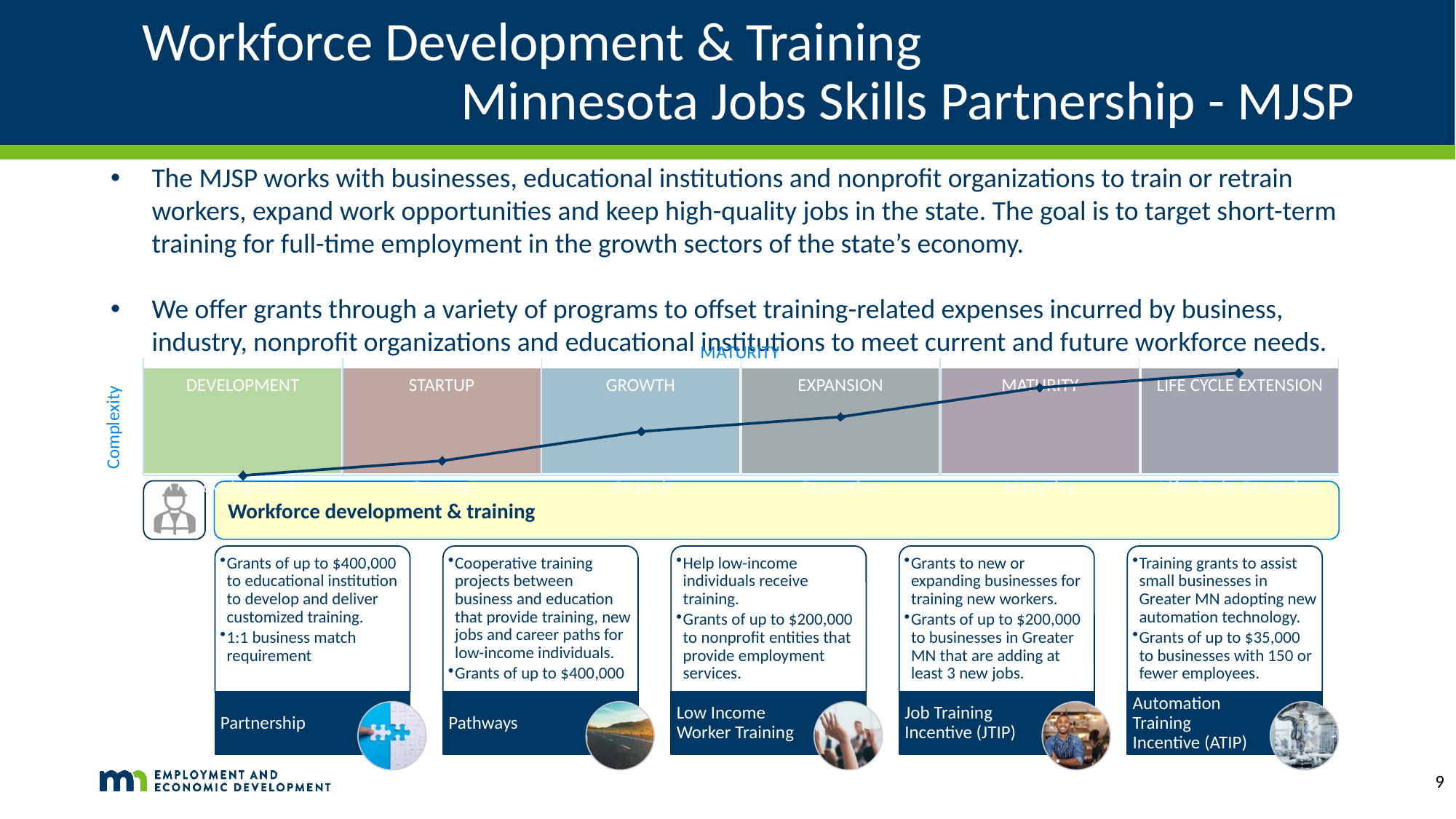
Does the plotted line rise or fall from Development to Life Cycle Extension? rise Which stage has the highest point on the line chart? Life Cycle Extension How many stages are labelled along the horizontal axis of the line chart? 6 Which has the higher plotted value on the line chart, Startup or Expansion? Expansion Which has the lower plotted value on the line chart, Growth or Maturity? Growth What kind of chart is shown over the life-cycle stage boxes on the slide? line chart Which stage has the lowest point on the line chart? Development How many data points are plotted on the line chart? 6 What is the label on the vertical axis of the line chart? Complexity